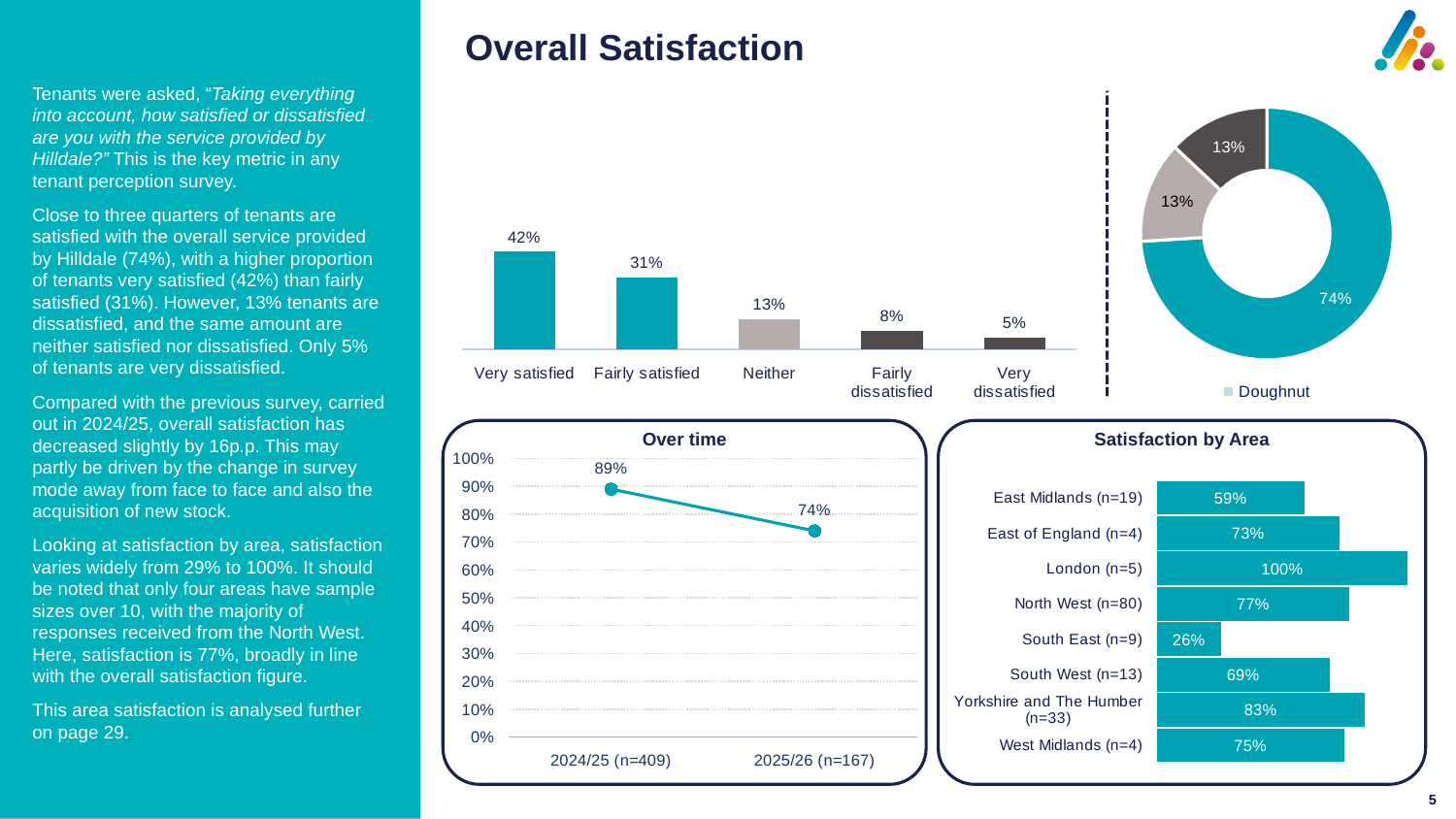
In the Over time chart, what is the difference between the 2024/25 and 2025/26 values? 15 percentage points What is the legend entry shown under the doughnut chart? Doughnut In the top-centre bar chart, what is the value for Very satisfied? 42% In the top-centre bar chart, which category has the lowest value? Very dissatisfied In the Over time chart, do values rise or fall from 2024/25 to 2025/26? fall In the Satisfaction by Area chart, which area has the highest value? London (n=5) In the Over time chart, what is the value for 2024/25 (n=409)? 89% In the doughnut chart, what is the value of the largest slice? 74% In the Satisfaction by Area chart, what is the value for South East (n=9)? 26% How many categories are shown in the top-centre bar chart? 5 In the Satisfaction by Area chart, which is larger: North West (n=80) or South West (n=13)? North West (n=80) In the top-centre bar chart, what is the difference between Very satisfied and Fairly satisfied? 11 percentage points